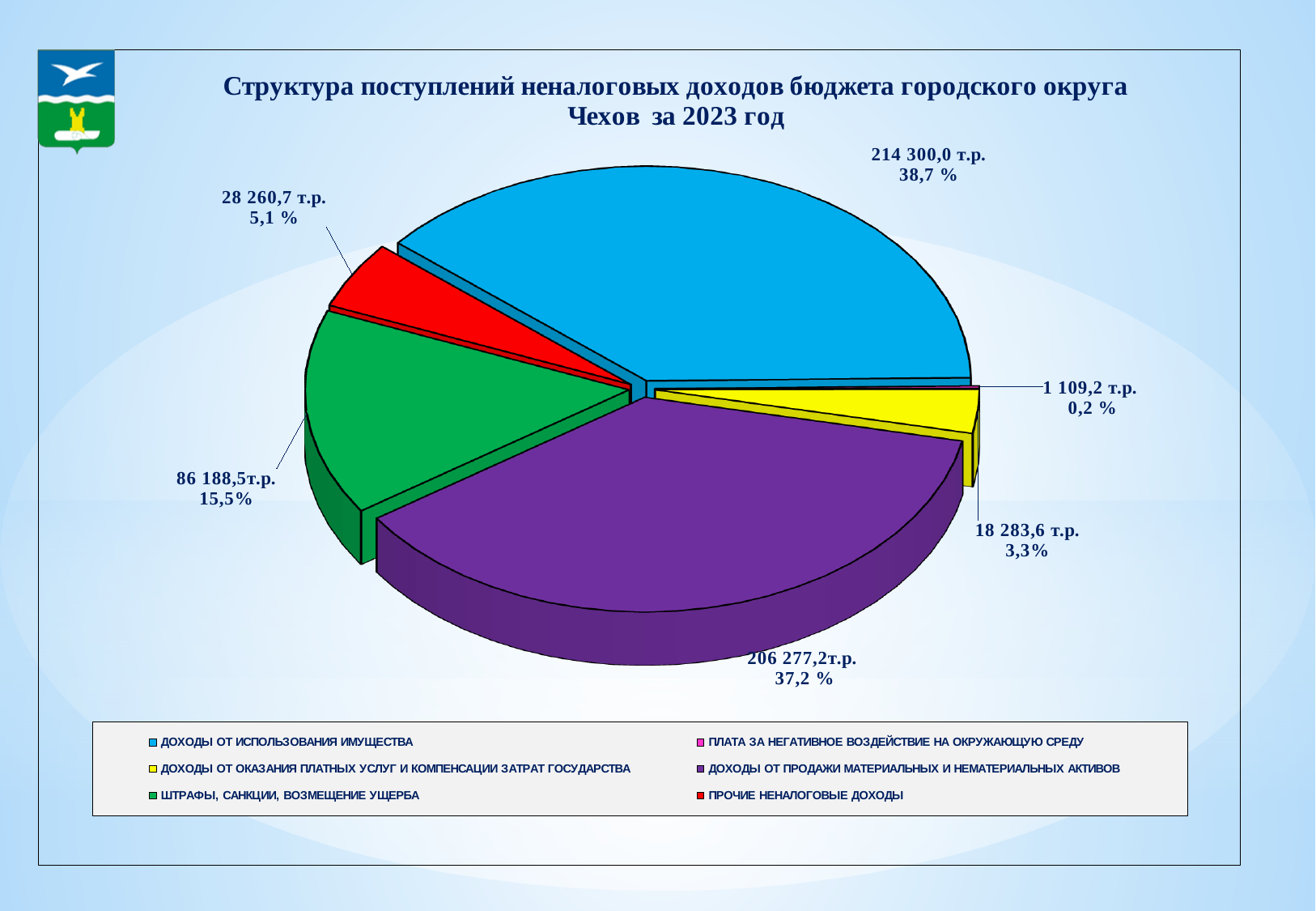
Which category has the smallest share of the pie? ПЛАТА ЗА НЕГАТИВНОЕ ВОЗДЕЙСТВИЕ НА ОКРУЖАЮЩУЮ СРЕДУ What share of the pie does ДОХОДЫ ОТ ПРОДАЖИ МАТЕРИАЛЬНЫХ И НЕМАТЕРИАЛЬНЫХ АКТИВОВ represent? 37,2 % What percentage share is shown for ПЛАТА ЗА НЕГАТИВНОЕ ВОЗДЕЙСТВИЕ НА ОКРУЖАЮЩУЮ СРЕДУ? 0,2 % What is the value in т.р. for ДОХОДЫ ОТ ИСПОЛЬЗОВАНИЯ ИМУЩЕСТВА? 214 300,0 т.р. What is the value in т.р. for ШТРАФЫ, САНКЦИИ, ВОЗМЕЩЕНИЕ УЩЕРБА? 86 188,5 т.р. Which colour represents ПРОЧИЕ НЕНАЛОГОВЫЕ ДОХОДЫ in the pie chart? Red What is the value in т.р. for ДОХОДЫ ОТ ОКАЗАНИЯ ПЛАТНЫХ УСЛУГ И КОМПЕНСАЦИИ ЗАТРАТ ГОСУДАРСТВА? 18 283,6 т.р. Which is larger: the value for ШТРАФЫ, САНКЦИИ, ВОЗМЕЩЕНИЕ УЩЕРБА or the value for ПРОЧИЕ НЕНАЛОГОВЫЕ ДОХОДЫ? ШТРАФЫ, САНКЦИИ, ВОЗМЕЩЕНИЕ УЩЕРБА What is the difference in percentage points between the share of ДОХОДЫ ОТ ИСПОЛЬЗОВАНИЯ ИМУЩЕСТВА and the share of ДОХОДЫ ОТ ПРОДАЖИ МАТЕРИАЛЬНЫХ И НЕМАТЕРИАЛЬНЫХ АКТИВОВ? 1,5 Which category has the largest share of the pie? ДОХОДЫ ОТ ИСПОЛЬЗОВАНИЯ ИМУЩЕСТВА How many categories does the legend of the pie chart list? 6 What kind of chart is shown on the slide? Pie chart